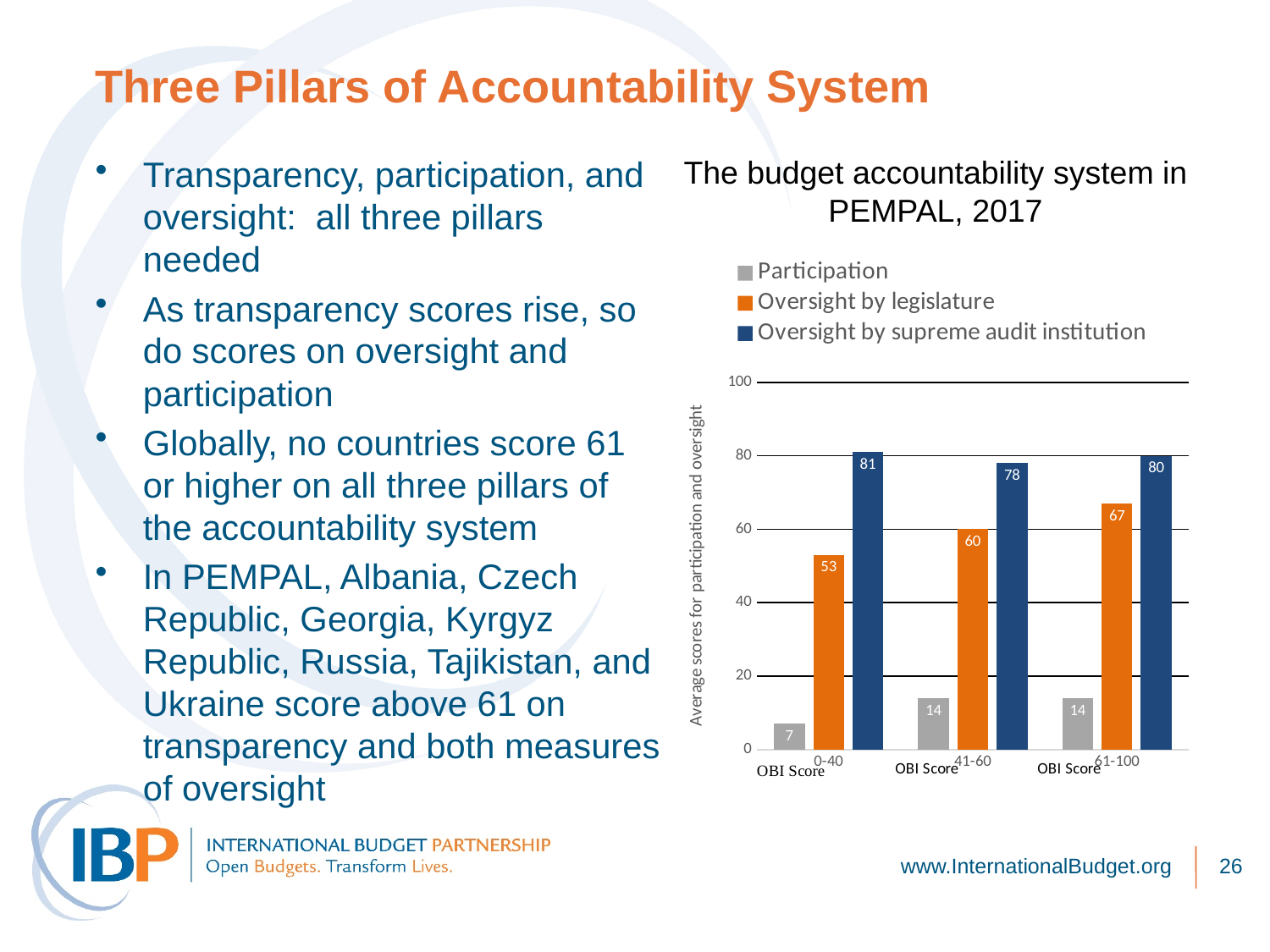
What kind of chart is shown on the slide? bar chart How many series does the legend list? 3 Which OBI Score group has the lowest Participation score? 0-40 What is the Oversight by supreme audit institution score for the OBI Score 61-100 group? 80 What is the Participation score for the OBI Score 0-40 group? 7 Which OBI Score group has the highest Oversight by legislature score? 61-100 How many OBI Score groups are shown on the x axis? 3 What is the difference between the Oversight by legislature scores for the 61-100 and 0-40 groups? 14 What is the Oversight by legislature score for the OBI Score 41-60 group? 60 Is the Oversight by legislature score for the 0-40 group greater or less than 60? less What is the title of the chart? The budget accountability system in PEMPAL, 2017 Which is larger: the Oversight by supreme audit institution score for the 0-40 group or for the 41-60 group? 0-40